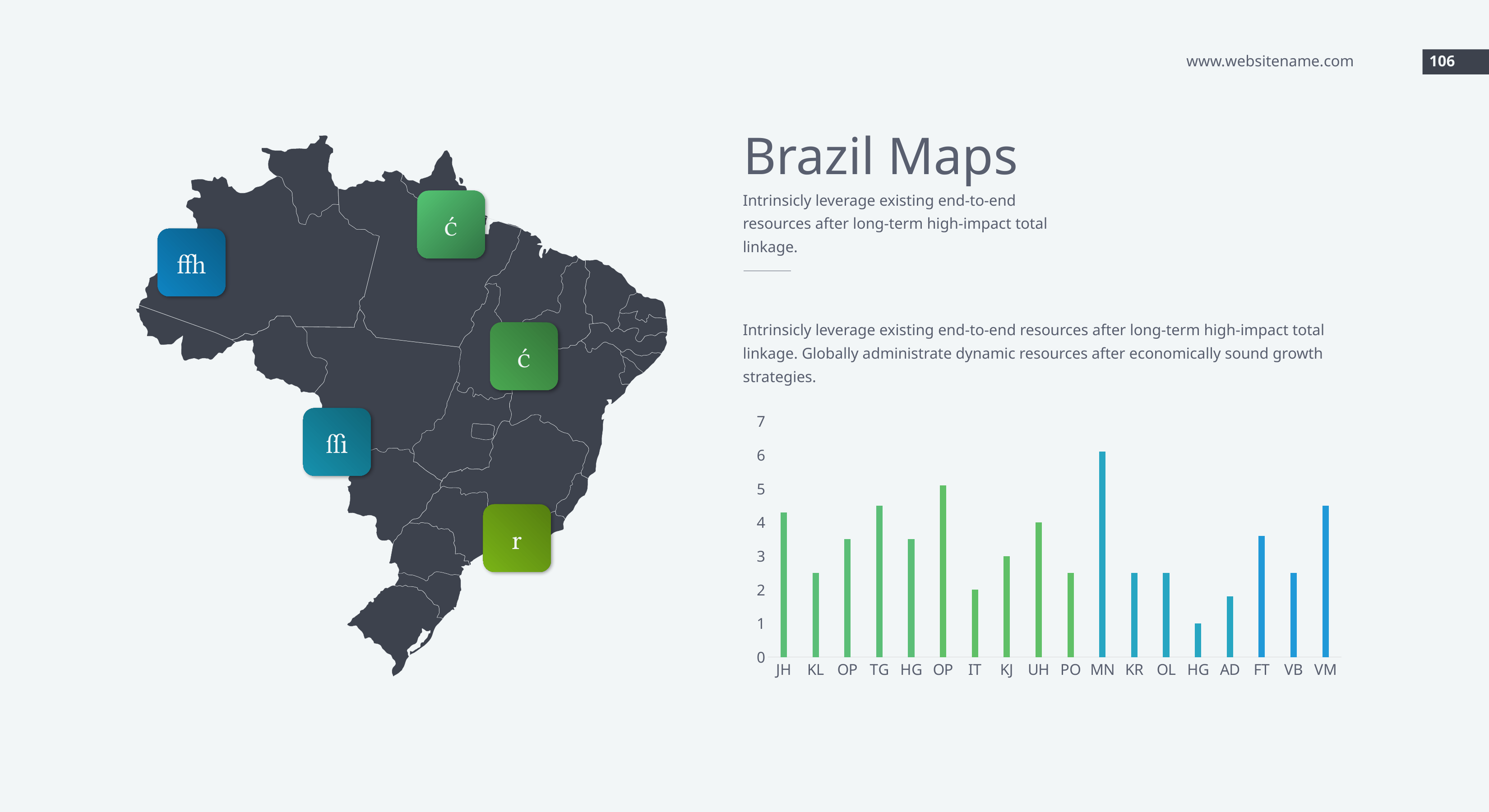
What is the highest value shown on the chart's vertical axis? 7 Which is larger, the value for MN or the value for VM? MN How many categories are shown on the x axis of the bar chart? 18 Is the value for UH greater or less than 3? greater What kind of chart is shown on the slide? bar chart Which category has the highest bar in the chart? MN Is the value for IT greater or less than 3? less Is the value for MN greater or less than 5? greater Which is larger, the value for JH or the value for KL? JH Which category has the lowest bar in the chart? HG